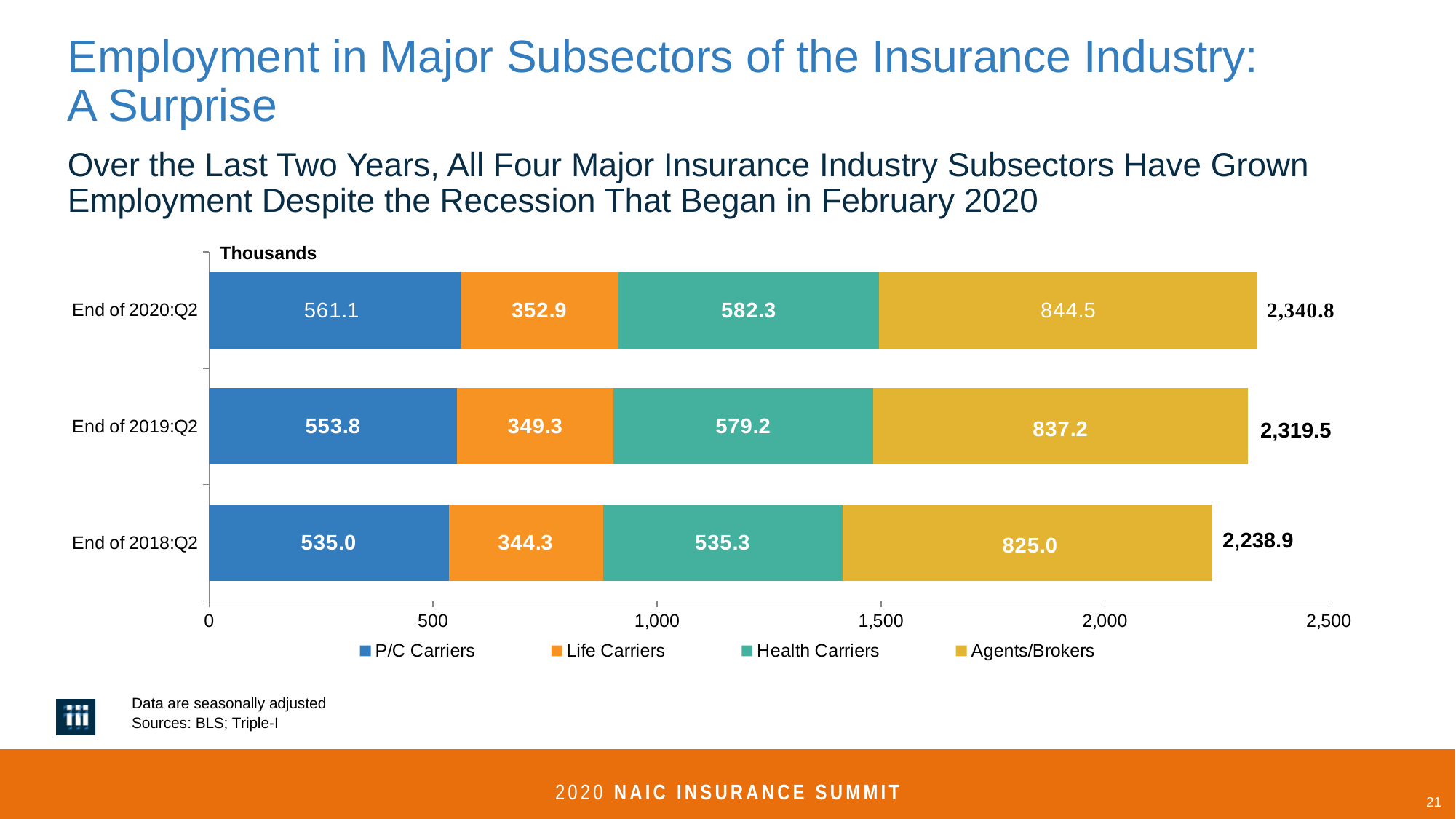
What is the difference between the Life Carriers values at End of 2020:Q2 and End of 2018:Q2? 8.6 What is the value for Health Carriers at End of 2019:Q2? 579.2 What is the value for P/C Carriers at End of 2020:Q2? 561.1 Is the Health Carriers value larger at End of 2020:Q2 or End of 2018:Q2? End of 2020:Q2 Which period has the lowest total employment? End of 2018:Q2 What is the value for Agents/Brokers at End of 2018:Q2? 825.0 Which series has the highest value at End of 2019:Q2? Agents/Brokers How many periods (categories) are shown on the chart? 3 What is the total of the stacked bar for End of 2020:Q2? 2,340.8 What kind of chart is shown? Stacked bar chart What unit label is shown at the top of the chart? Thousands How many series does the legend list? 4